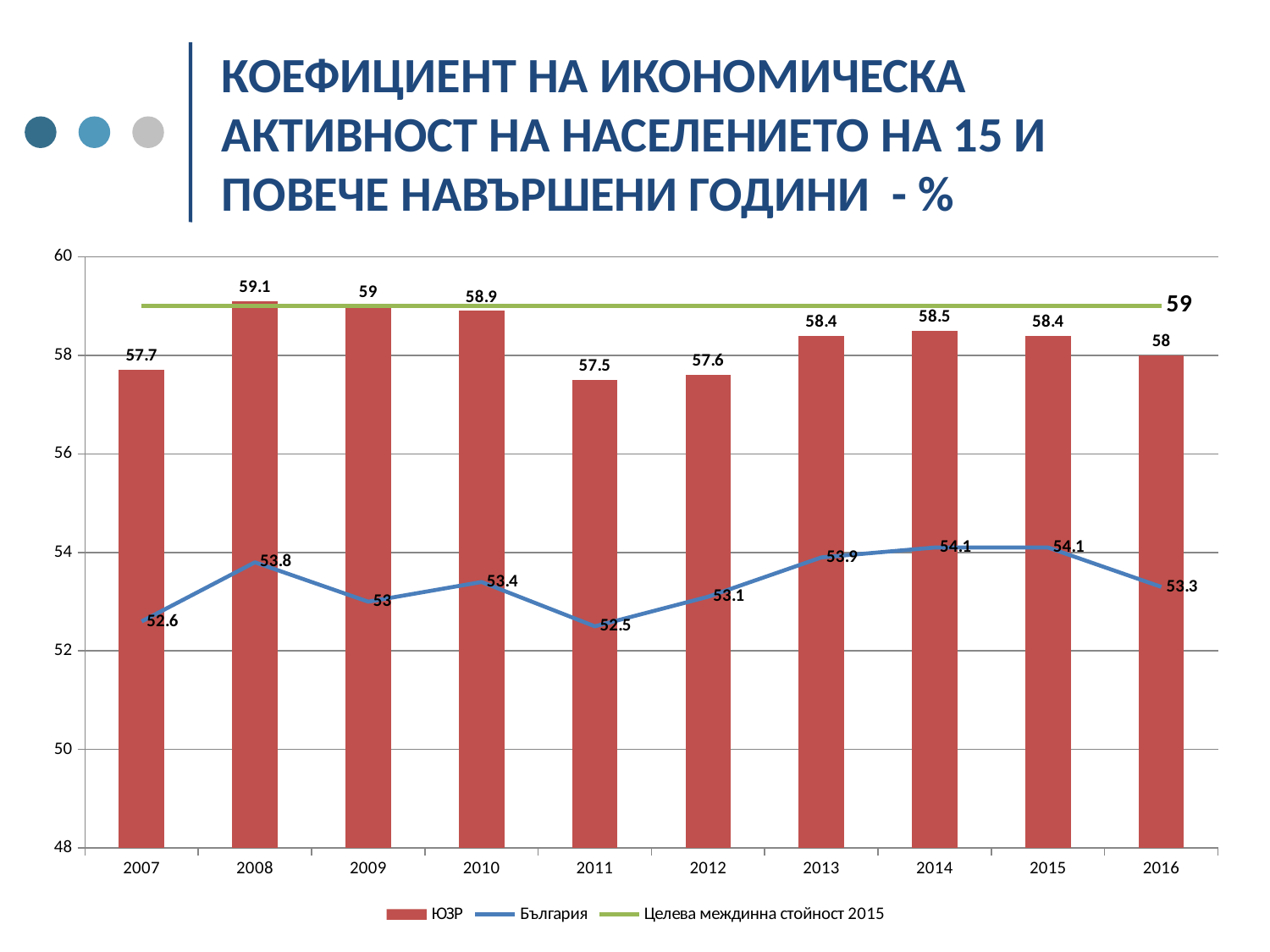
What is the value of the България line for 2011? 52.5 Which year has the highest ЮЗР bar? 2008 What value does the Целева междинна стойност 2015 line show? 59 How many series does the legend list? 3 How many years are shown on the x axis? 10 What colour are the ЮЗР bars? red Which is larger, the ЮЗР value for 2013 or for 2014? 2014 What is the difference between the ЮЗР values for 2008 and 2011? 1.6 Does the България line rise or fall from 2015 to 2016? fall What is the value of the ЮЗР bar for 2008? 59.1 Which year has the lowest value on the България line? 2011 What is the value of the ЮЗР bar for 2016? 58